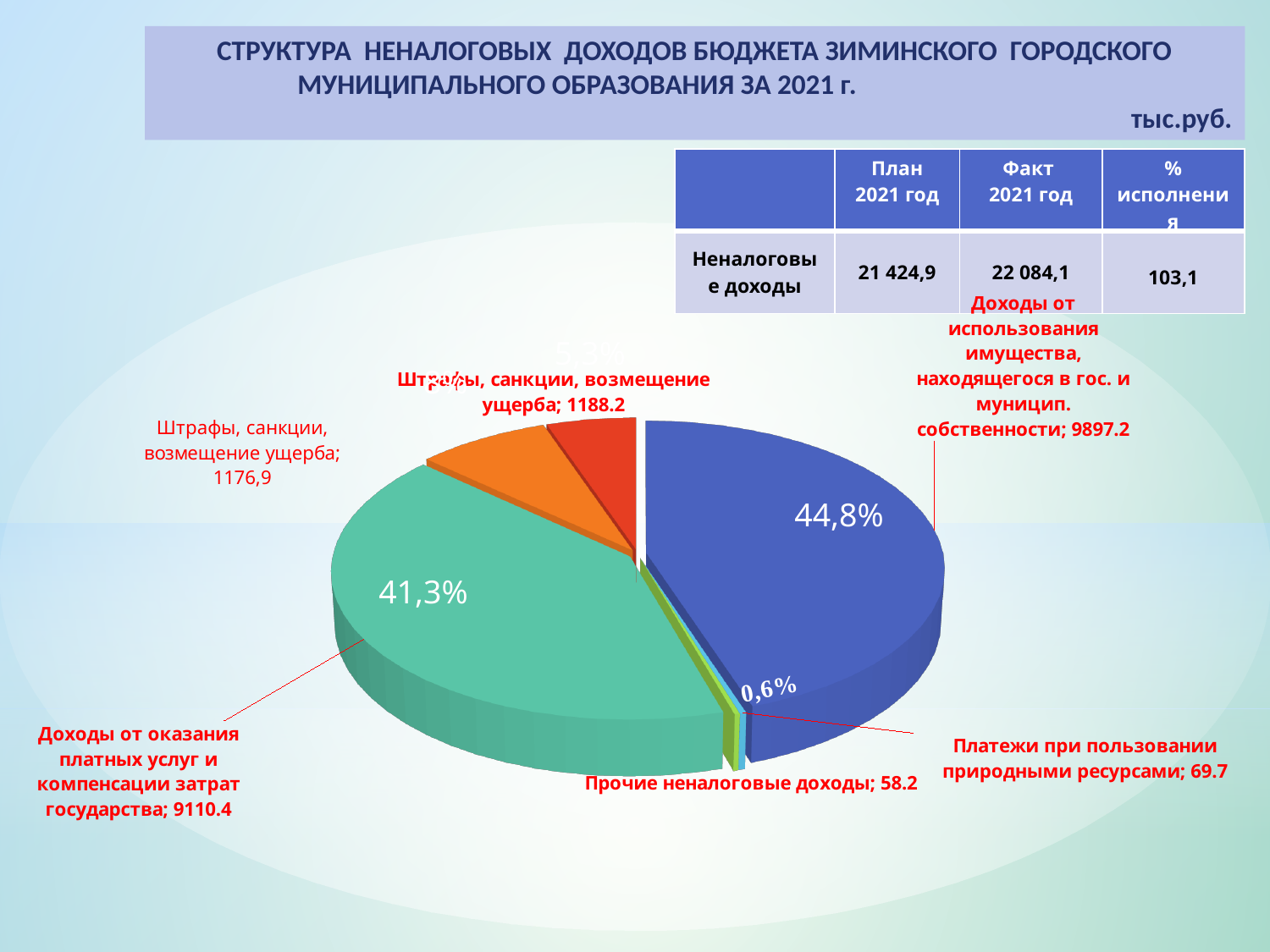
What is the value for "Прочие неналоговые доходы"? 58.2 What share of the pie does "Доходы от оказания платных услуг и компенсации затрат государства" take? 41,3% What is the value for "Доходы от оказания платных услуг и компенсации затрат государства"? 9110.4 Which is larger: "Прочие неналоговые доходы" or "Платежи при пользовании природными ресурсами"? Платежи при пользовании природными ресурсами What is the difference between "Доходы от использования имущества" (9897.2) and "Доходы от оказания платных услуг и компенсации затрат государства" (9110.4)? 786.8 What is the value for "Платежи при пользовании природными ресурсами"? 69.7 Which category has the largest slice of the pie? Доходы от использования имущества, находящегося в гос. и муницип. собственности What kind of chart is shown on the slide? pie chart What is the title of the chart on the slide? СТРУКТУРА НЕНАЛОГОВЫХ ДОХОДОВ БЮДЖЕТА ЗИМИНСКОГО ГОРОДСКОГО МУНИЦИПАЛЬНОГО ОБРАЗОВАНИЯ ЗА 2021 г. Which is larger: "Доходы от использования имущества" or "Доходы от оказания платных услуг и компенсации затрат государства"? Доходы от использования имущества What share of the pie does "Доходы от использования имущества, находящегося в гос. и муницип. собственности" take? 44,8% What is the value for "Доходы от использования имущества, находящегося в гос. и муницип. собственности"? 9897.2